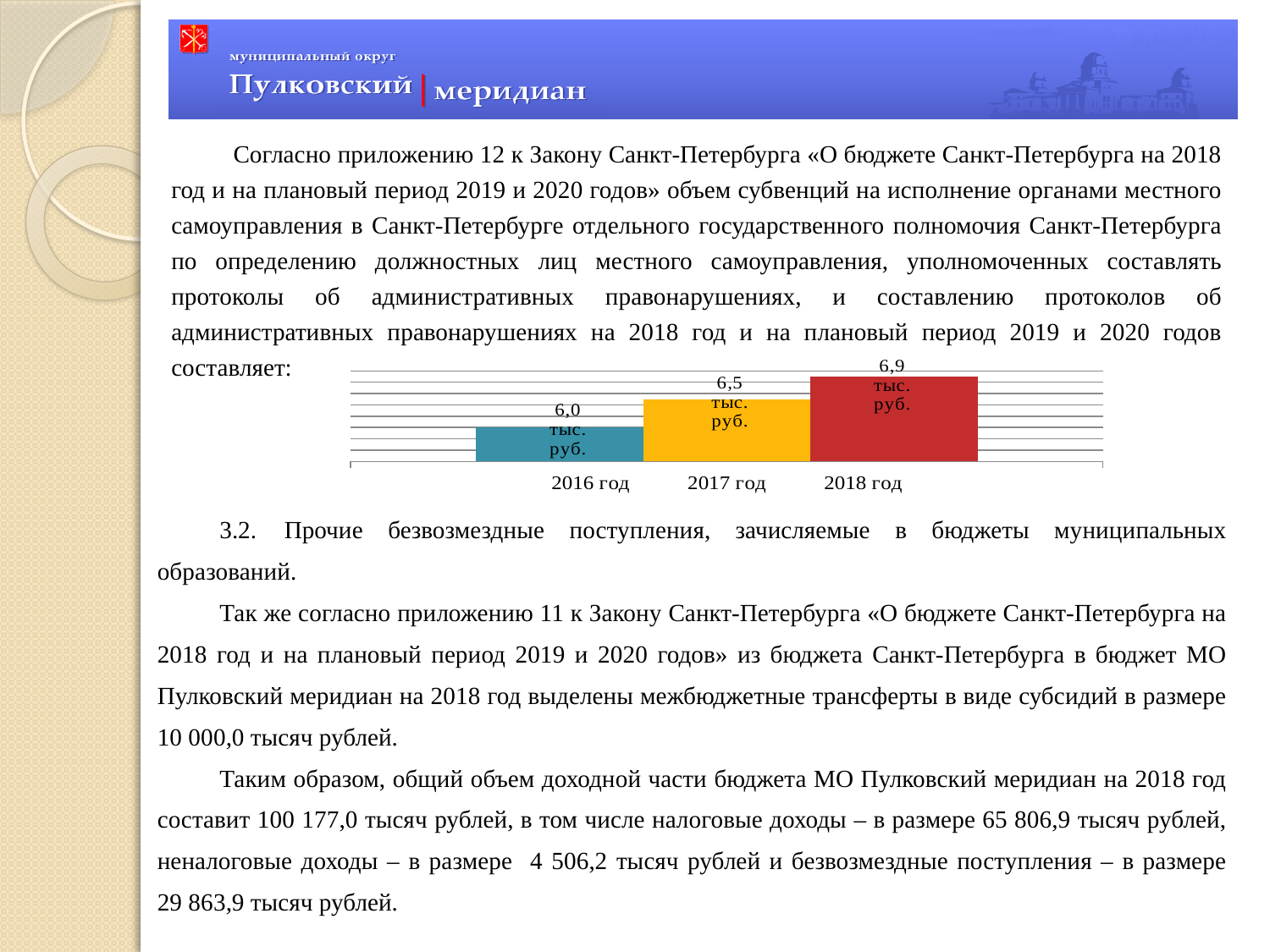
What is the value shown for 2018 год in the chart? 6,9 тыс. руб. Which year has the lowest value in the chart? 2016 год Which is larger, the value for 2017 год or the value for 2018 год? 2018 год How many years (categories) are shown in the chart? 3 What is the value shown for 2016 год in the chart? 6,0 тыс. руб. Which year has the highest value in the chart? 2018 год What is the difference between the values for 2017 год and 2016 год? 0,5 тыс. руб. What kind of chart is shown on the slide? Bar chart By how much does the value for 2018 год exceed the value for 2016 год? 0,9 тыс. руб. Do the values rise or fall from 2016 год to 2018 год? Rise What is the value shown for 2017 год in the chart? 6,5 тыс. руб. What colour is the bar for 2018 год? Red